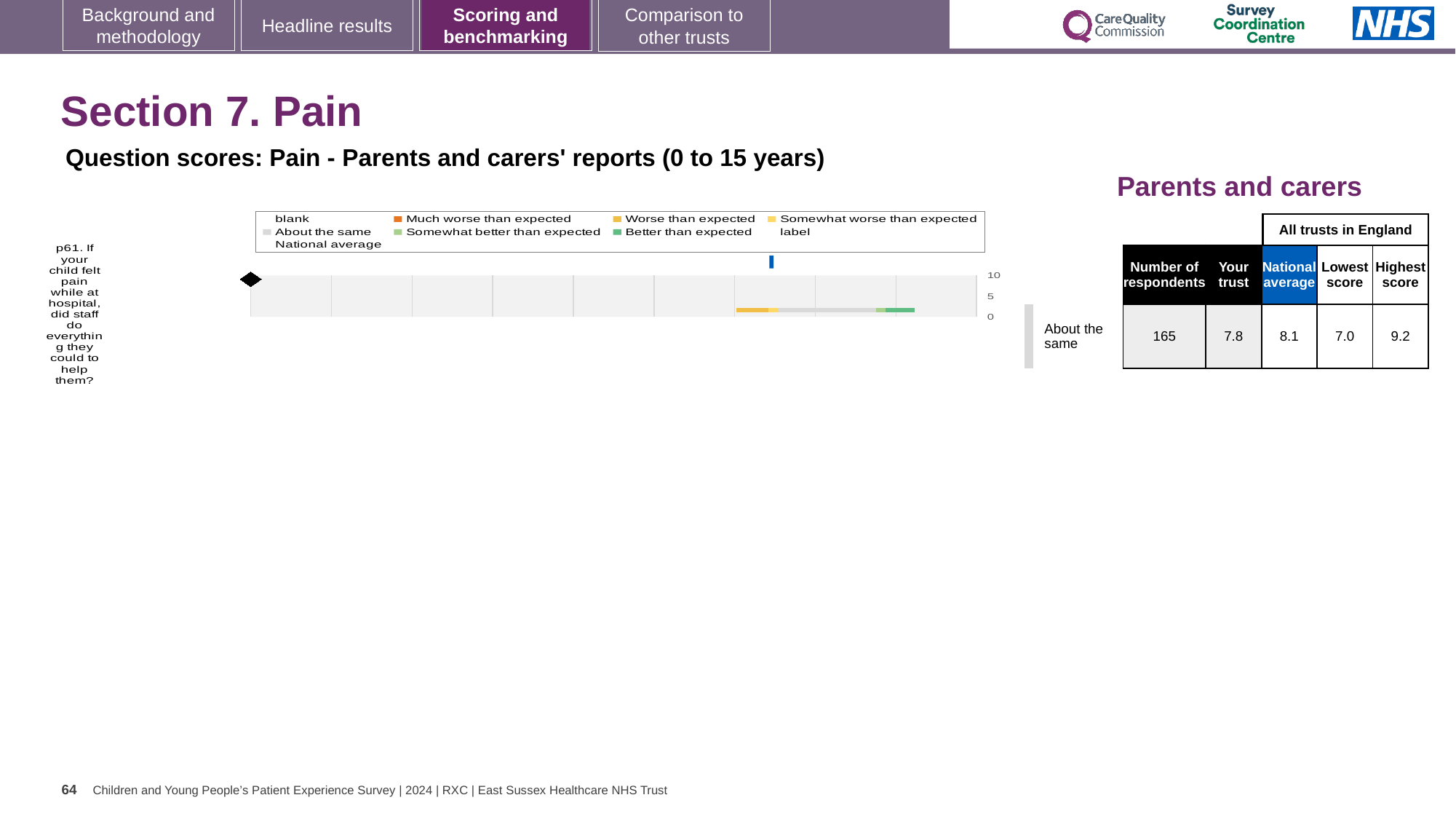
According to the table beside the chart, what is the score for Your trust on question p61? 7.8 What is the difference between the Highest score and the Lowest score for question p61? 2.2 According to the table beside the chart, what is the National average score for question p61? 8.1 Which is larger for question p61: the Your trust score or the National average score? National average What kind of chart is shown on the slide? bar chart Is the national average marker on the chart greater or less than 5? greater According to the table beside the chart, how many respondents answered question p61? 165 How many survey questions are plotted in the chart? 1 What is the difference between the National average score and the Your trust score for question p61? 0.3 What is the highest value shown on the chart's axis? 10 How many entries does the chart legend list? 9 Which legend entry is shown in orange? Much worse than expected